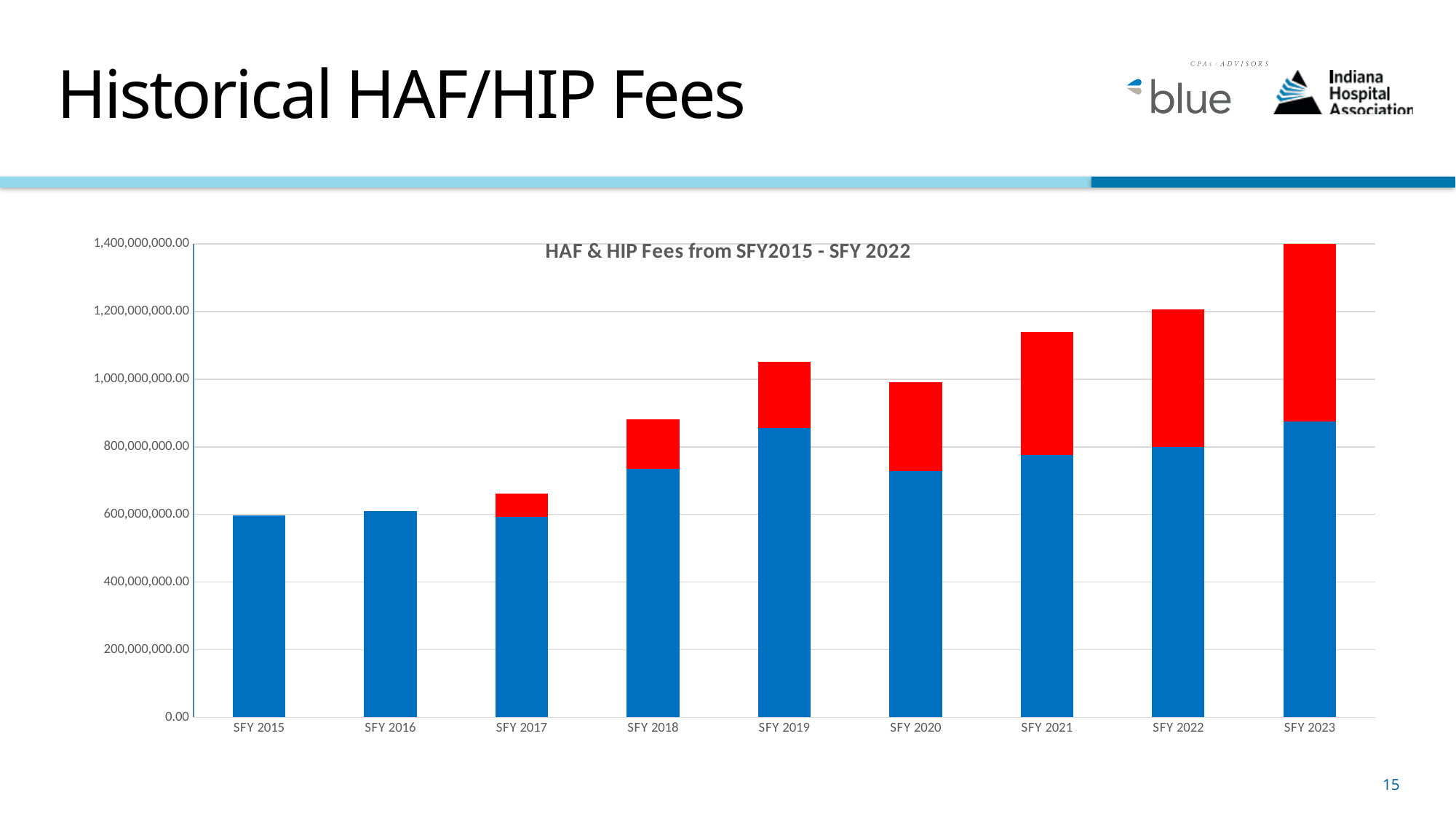
What kind of chart is shown on the slide? Stacked bar chart How many state fiscal years (bars) are plotted in the chart? 9 Which is the first state fiscal year whose bar includes a red segment? SFY 2017 What is the title of the chart? HAF & HIP Fees from SFY2015 - SFY 2022 Is the total bar for SFY 2017 greater or less than 800,000,000.00? less Is the total bar for SFY 2021 greater or less than 1,000,000,000.00? greater Which state fiscal year has the lowest total bar? SFY 2015 Is the total bar for SFY 2018 greater or less than 1,000,000,000.00? less Which state fiscal year has the highest total bar? SFY 2023 Which has the larger total bar, SFY 2019 or SFY 2020? SFY 2019 Do the total bar heights generally rise or fall from SFY 2015 to SFY 2023? rise